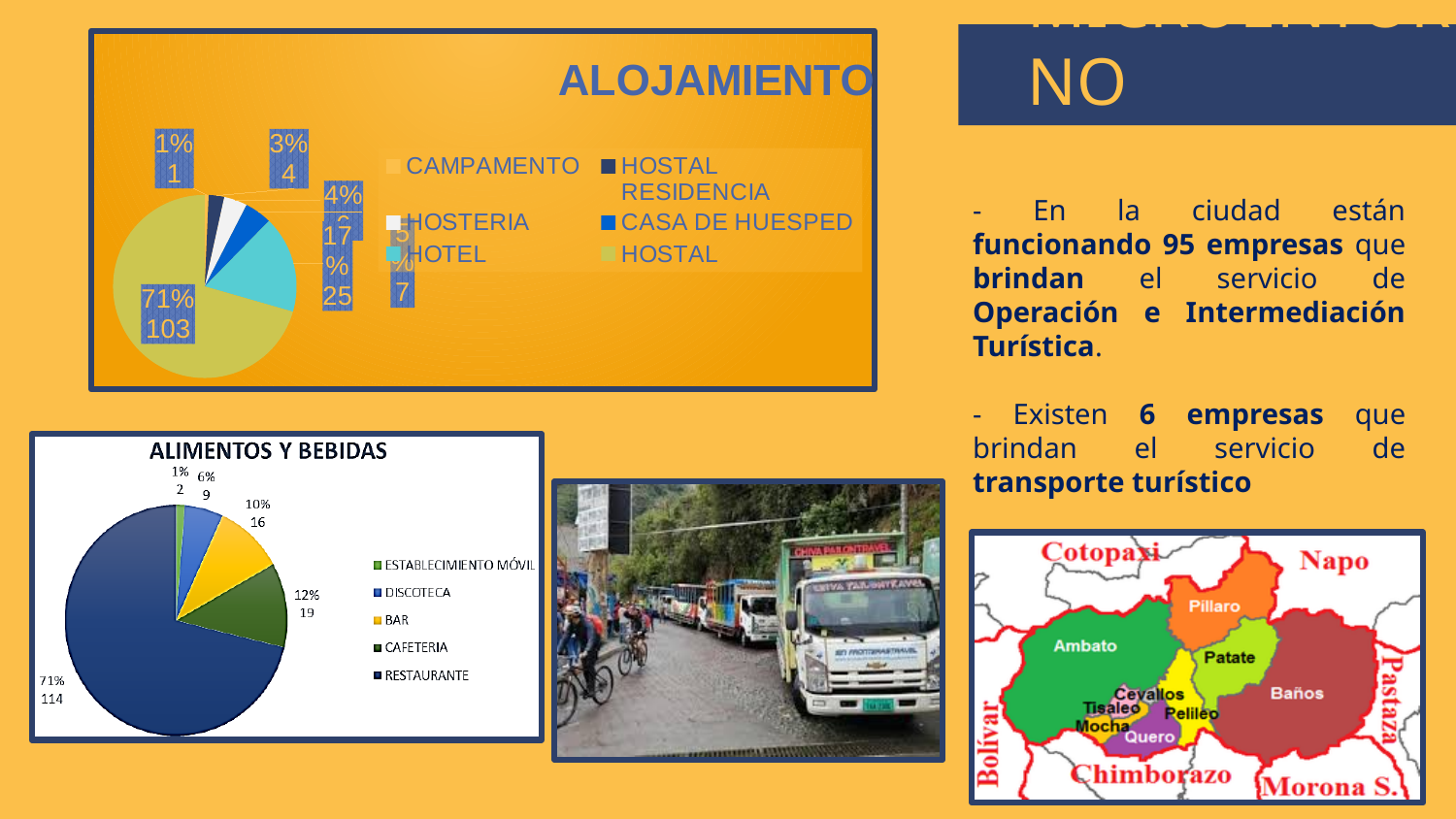
How many categories does the legend of the ALOJAMIENTO chart list? 6 In the ALIMENTOS Y BEBIDAS chart, what percentage share does CAFETERIA have? 12% In the ALIMENTOS Y BEBIDAS chart, what is the count shown for RESTAURANTE? 114 What kind of chart is the ALOJAMIENTO chart? Pie chart How many categories does the legend of the ALIMENTOS Y BEBIDAS chart list? 5 In the ALIMENTOS Y BEBIDAS chart, what is the count shown for BAR? 16 In the ALIMENTOS Y BEBIDAS chart, which category has the largest slice? RESTAURANTE In the ALIMENTOS Y BEBIDAS chart, which is larger, the count for BAR or the count for DISCOTECA? BAR In the ALOJAMIENTO chart, what percentage share does the largest slice have? 71% In the ALIMENTOS Y BEBIDAS chart, what percentage share does RESTAURANTE have? 71% In the ALIMENTOS Y BEBIDAS chart, what is the difference between the counts for CAFETERIA and DISCOTECA? 10 In the ALIMENTOS Y BEBIDAS chart, which category has the smallest slice? ESTABLECIMIENTO MÓVIL